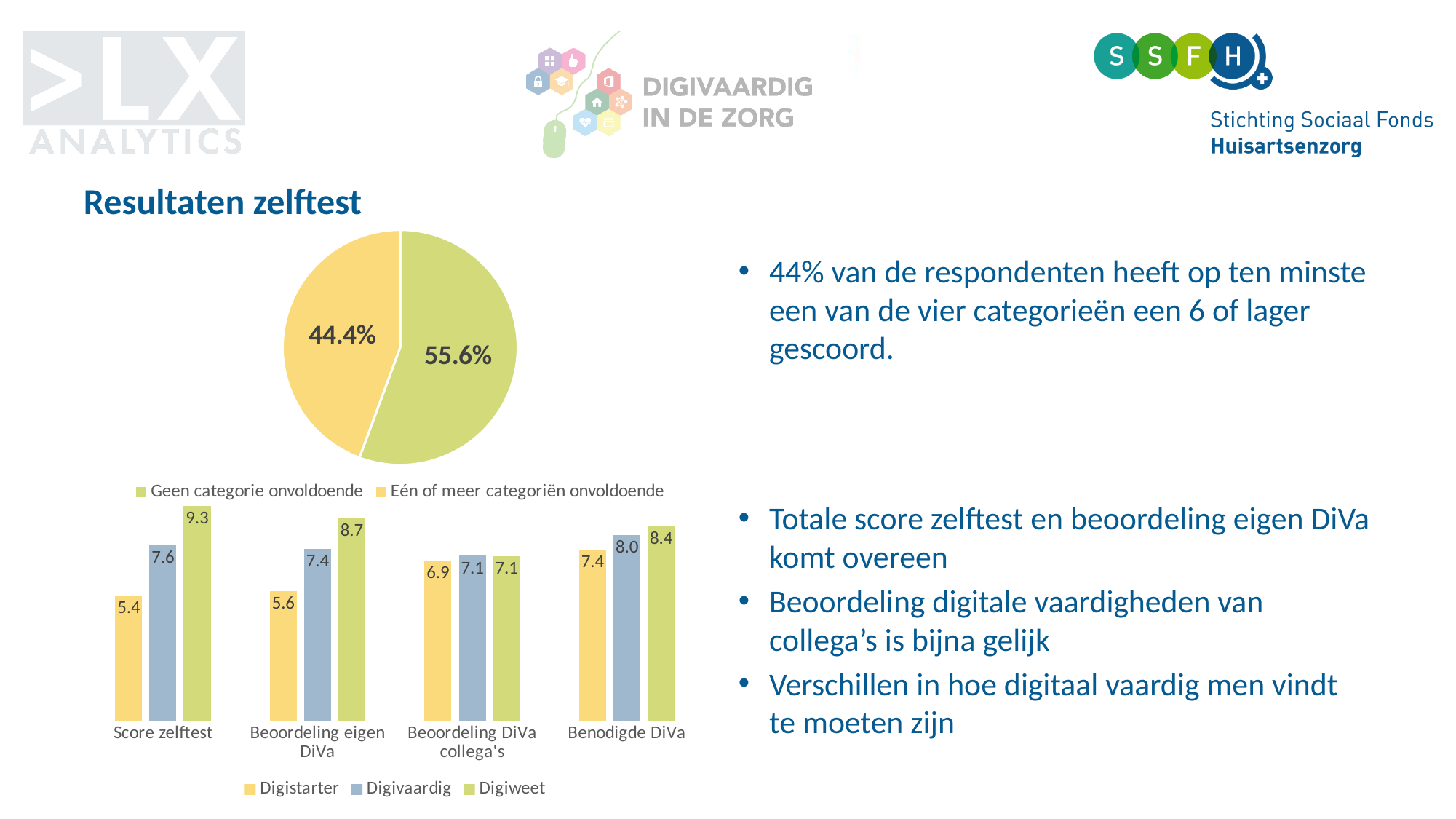
In the bar chart, which category has the lowest Digistarter value? Score zelftest In the bar chart, what is the Digiweet value for 'Score zelftest'? 9.3 What kind of chart is the top chart on the slide? Pie chart In the bar chart, what is the difference between the Digiweet and Digistarter values for 'Score zelftest'? 3.9 In the pie chart, which slice is larger: 'Geen categorie onvoldoende' or 'Eén of meer categoriën onvoldoende'? Geen categorie onvoldoende In the pie chart, what share is labelled 'Geen categorie onvoldoende'? 55.6% How many series does the legend of the bar chart list? 3 What kind of chart is the bottom chart on the slide? Bar chart In the bar chart, what is the Digistarter value for 'Beoordeling eigen DiVa'? 5.6 In the pie chart, what share is labelled 'Eén of meer categoriën onvoldoende'? 44.4% In the bar chart, what is the Digivaardig value for 'Benodigde DiVa'? 8.0 How many categories are shown on the x axis of the bar chart? 4